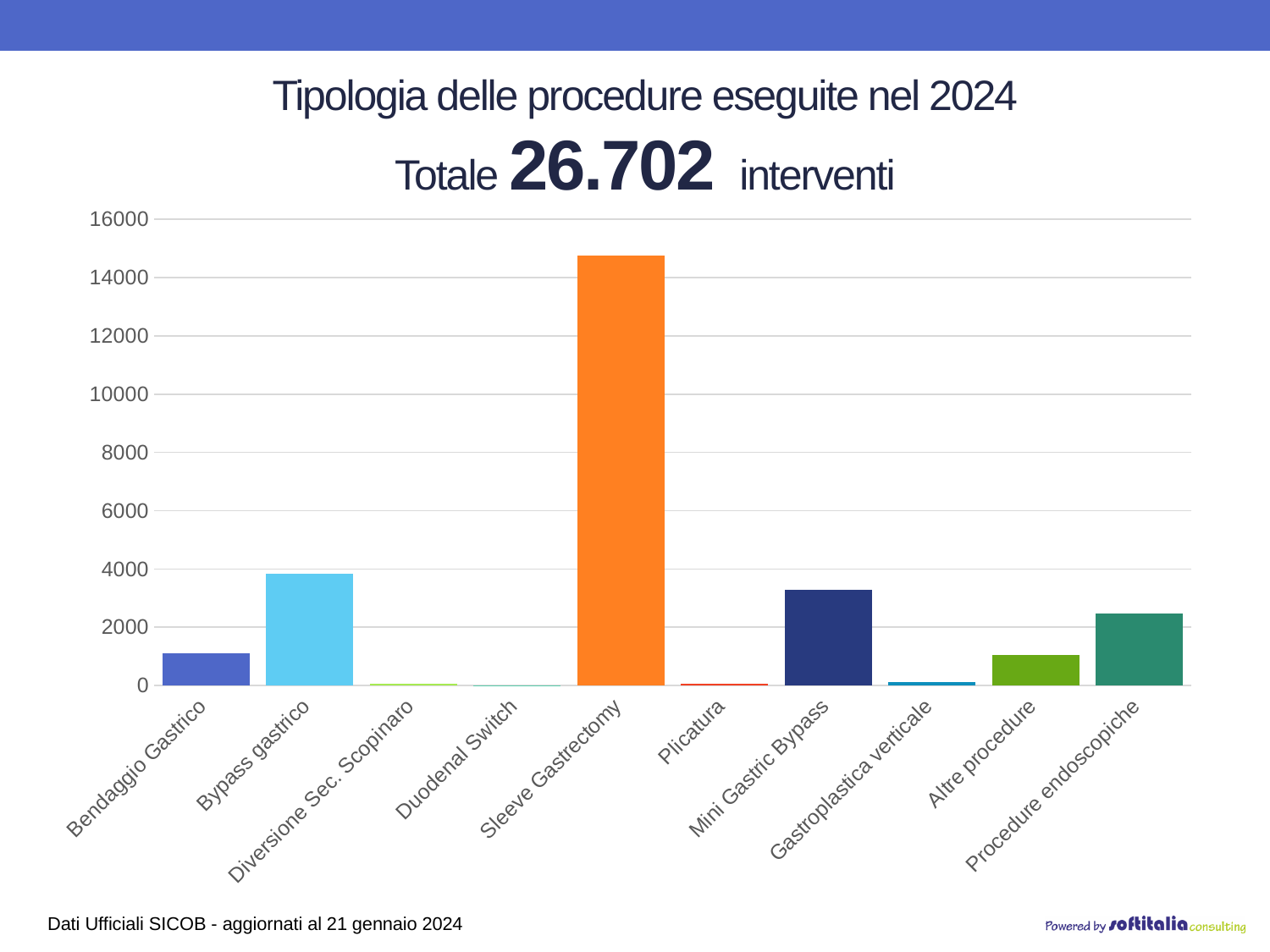
What total number of interventions is stated above the chart? 26.702 Is the value for Sleeve Gastrectomy greater or less than 14000? greater Is the value for Bypass gastrico greater or less than 2000? greater Is the value for Bendaggio Gastrico greater or less than 2000? less What is the title of the chart? Tipologia delle procedure eseguite nel 2024 What kind of chart is shown on the slide? bar chart How many procedure categories are shown on the x axis? 10 Which is larger, the value for Bypass gastrico or the value for Mini Gastric Bypass? Bypass gastrico Which procedure has the highest number of interventions? Sleeve Gastrectomy Which is larger, the value for Procedure endoscopiche or the value for Altre procedure? Procedure endoscopiche